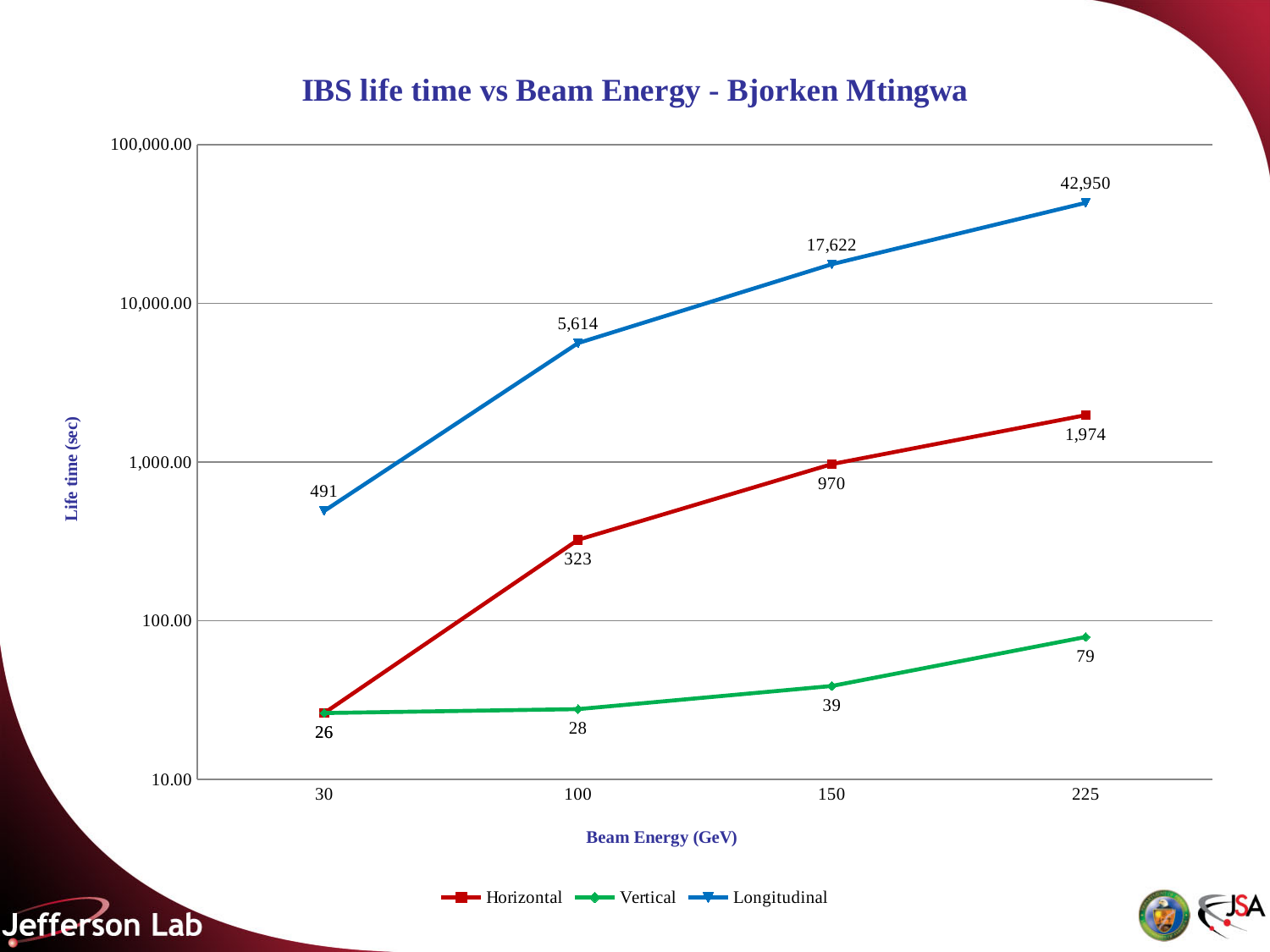
At 100 GeV, which is larger: the Horizontal or the Vertical life time? Horizontal What is the difference between the Longitudinal life time at 225 GeV and at 150 GeV? 25,328 How many series does the legend list? 3 What is the Vertical life time at a beam energy of 100 GeV? 28 How many beam energy values are plotted on the x axis? 4 What is the Horizontal life time at a beam energy of 150 GeV? 970 What kind of chart is shown on the slide? line chart What is the Longitudinal life time at a beam energy of 225 GeV? 42,950 What is the Longitudinal life time at a beam energy of 30 GeV? 491 At which beam energy is the Longitudinal life time lowest? 30 Is the Horizontal life time at 225 GeV greater or less than 1,000.00? greater Which series has the highest life time at 225 GeV? Longitudinal